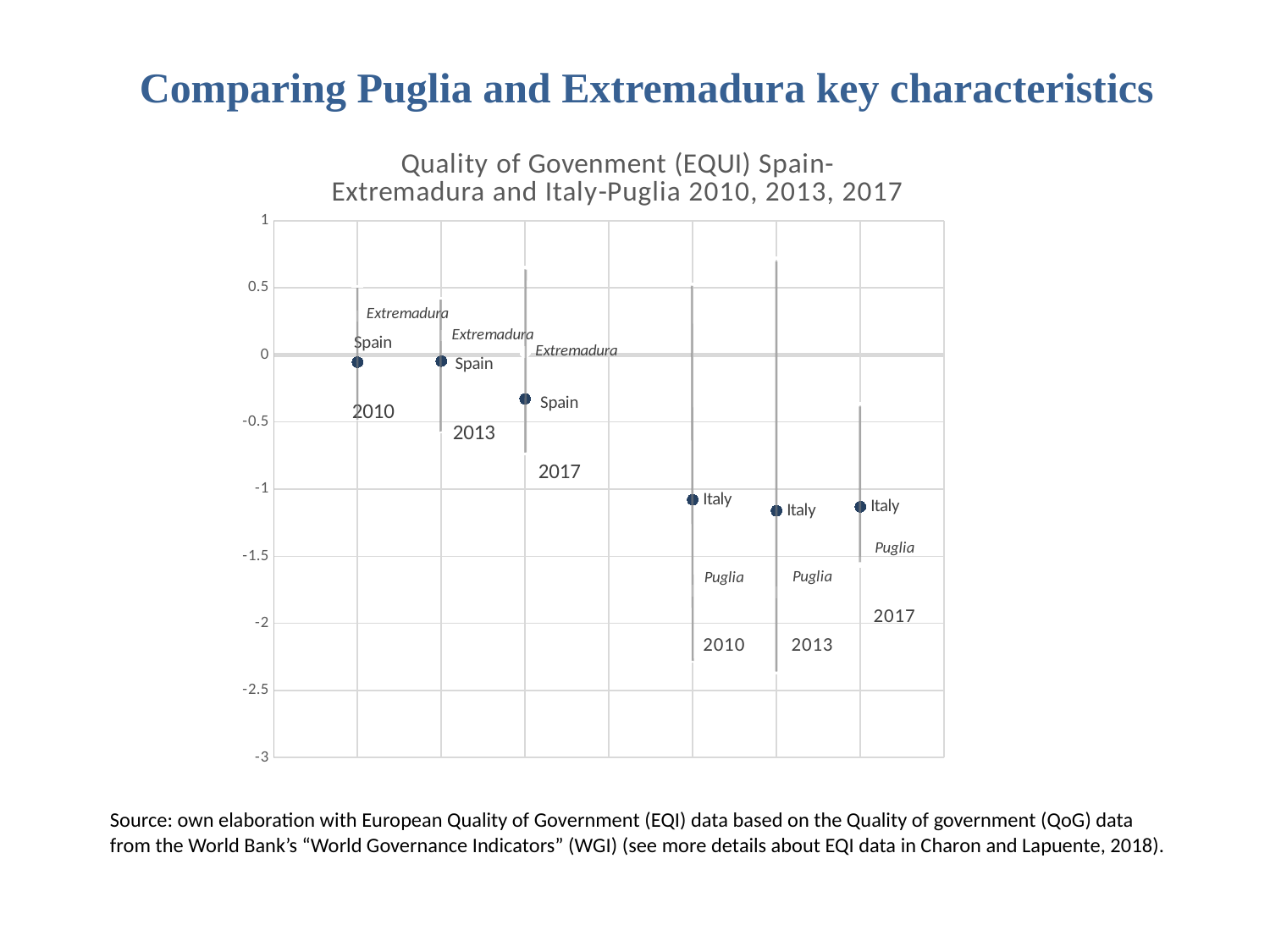
Is the value for Spain in 2017 greater or less than -0.5? greater What is the title of the chart? Quality of Govenment (EQUI) Spain-Extremadura and Italy-Puglia 2010, 2013, 2017 Is the value for Italy in 2013 greater or less than -1? less What kind of chart is shown on the slide? Scatter (dot) chart with error bars Which is higher, the value for Spain in 2017 or the value for Italy in 2017? Spain in 2017 Is the value for Italy in 2013 greater or less than -1.5? greater How many data points are plotted on the chart? 6 Do the values for Spain rise or fall from 2010 to 2017? fall Which is higher, the value for Spain in 2010 or the value for Spain in 2017? Spain in 2010 Which years are shown on the chart? 2010, 2013, 2017